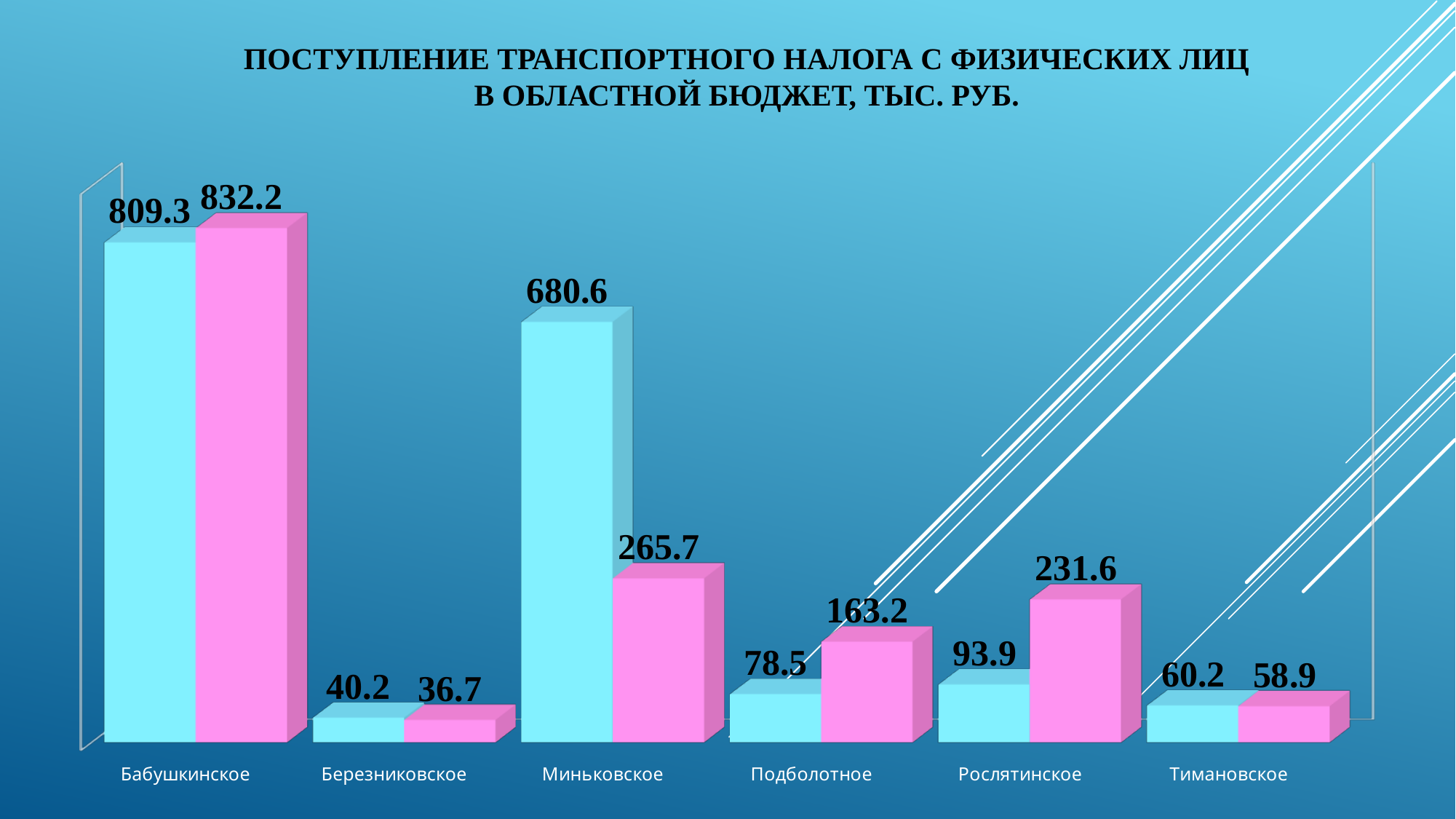
For Подболотное, which is larger: the light blue bar or the pink bar? the pink bar What kind of chart is shown on the slide? bar chart What is the value of the light blue bar for Миньковское? 680.6 What is the difference between the light blue and pink bars for Миньковское? 414.9 What is the value of the pink bar for Березниковское? 36.7 What is the value of the light blue bar for Подболотное? 78.5 Which category has the lowest light blue bar? Березниковское What is the difference between the pink and light blue bars for Рослятинское? 137.7 How many categories are shown on the x axis? 6 What is the title of the chart? ПОСТУПЛЕНИЕ ТРАНСПОРТНОГО НАЛОГА С ФИЗИЧЕСКИХ ЛИЦ В ОБЛАСТНОЙ БЮДЖЕТ, ТЫС. РУБ. Which category has the highest pink bar? Бабушкинское What is the value of the pink bar for Рослятинское? 231.6